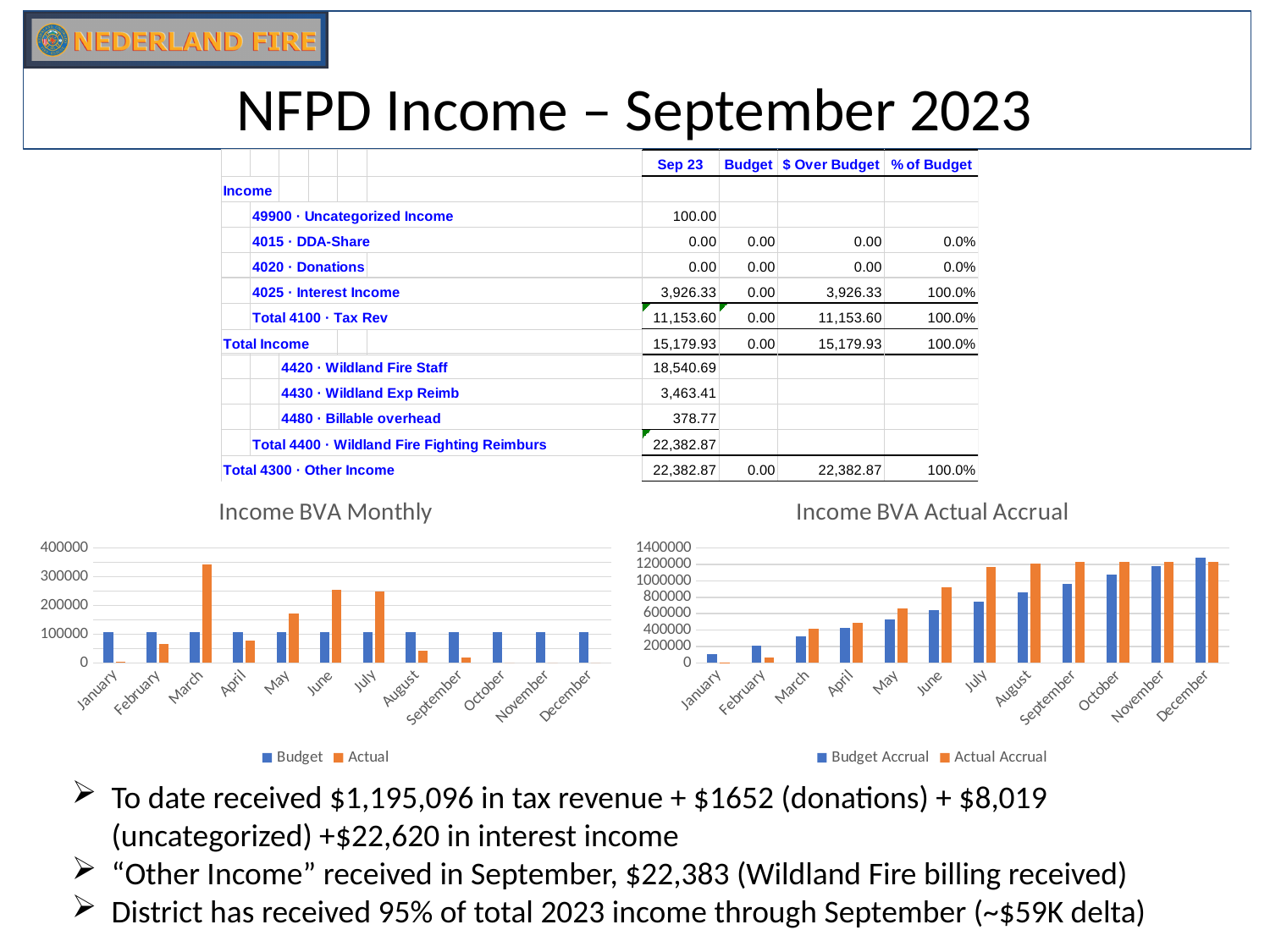
In the Income BVA Monthly chart, which is larger for June, Budget or Actual? Actual In the Income BVA Actual Accrual chart, what are the two legend entries? Budget Accrual and Actual Accrual In the Income BVA Monthly chart, is the Actual value for August greater or less than 100000? less In the Income BVA Monthly chart, how many months are shown on the x axis? 12 In the Income BVA Actual Accrual chart, which is larger for March, Budget Accrual or Actual Accrual? Actual Accrual In the Income BVA Monthly chart, how many series does the legend list? 2 In the Income BVA Actual Accrual chart, do the Budget Accrual values rise or fall from January to December? rise In the Income BVA Monthly chart, is the Actual value for March greater or less than 300000? greater In the Income BVA Actual Accrual chart, is the Actual Accrual value for July greater or less than 1000000? greater In the Income BVA Monthly chart, which month has the highest Actual value? March In the Income BVA Monthly chart, what kind of chart is shown? bar chart What is the title of the chart on the right side of the slide? Income BVA Actual Accrual